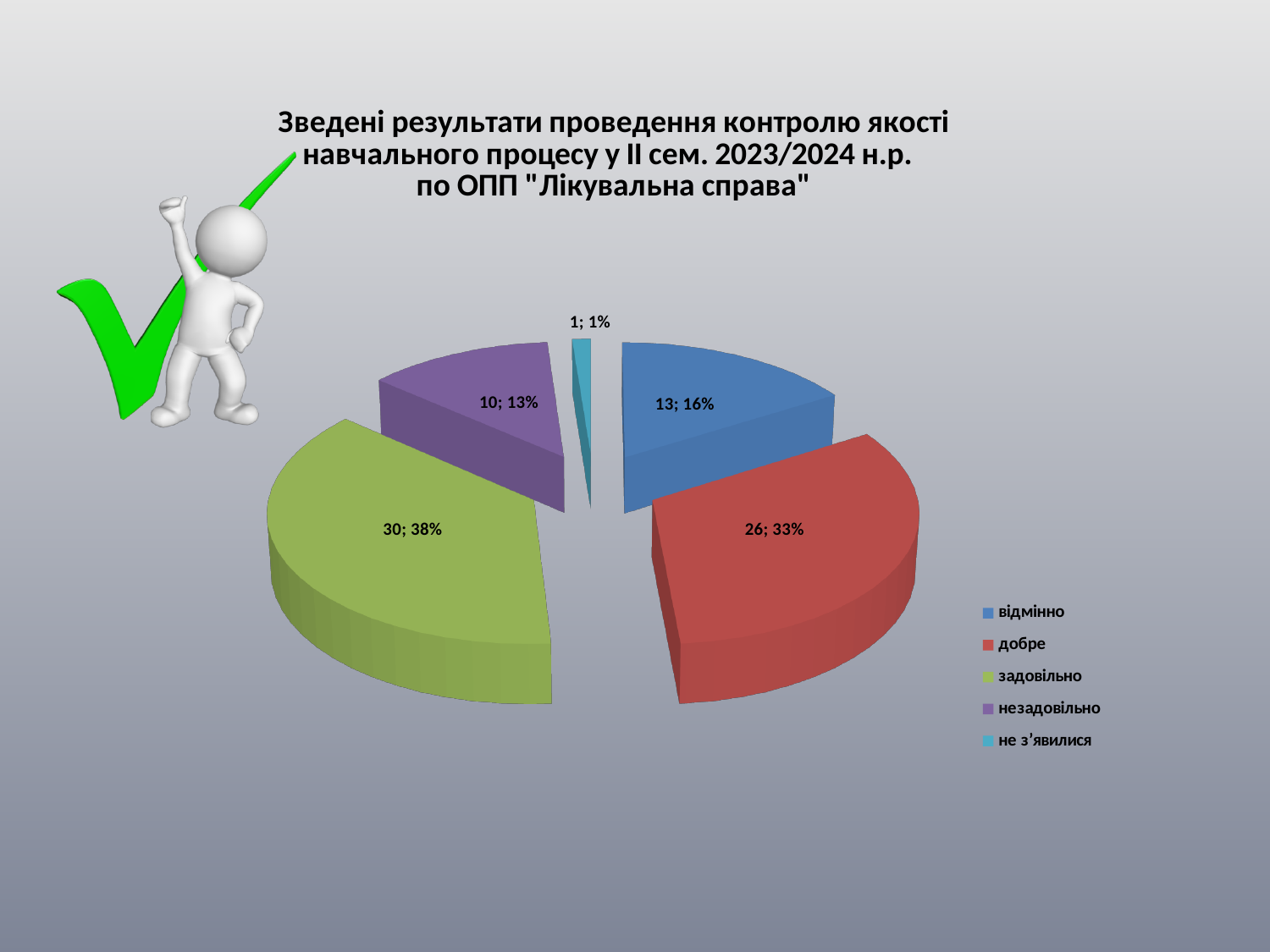
What is the value for "незадовільно"? 10 What is the difference between the values for "задовільно" and "добре"? 4 What is the value for "задовільно"? 30 Which category has the smallest slice? не з'явилися What is the value for "відмінно"? 13 What percentage share does "добре" have? 33% Which is larger, the value for "відмінно" or the value for "незадовільно"? відмінно How many slices does the pie chart have? 5 How many entries does the legend list? 5 What percentage share does "не з'явилися" have? 1% Which category has the largest slice? задовільно What kind of chart is shown on the slide? pie chart